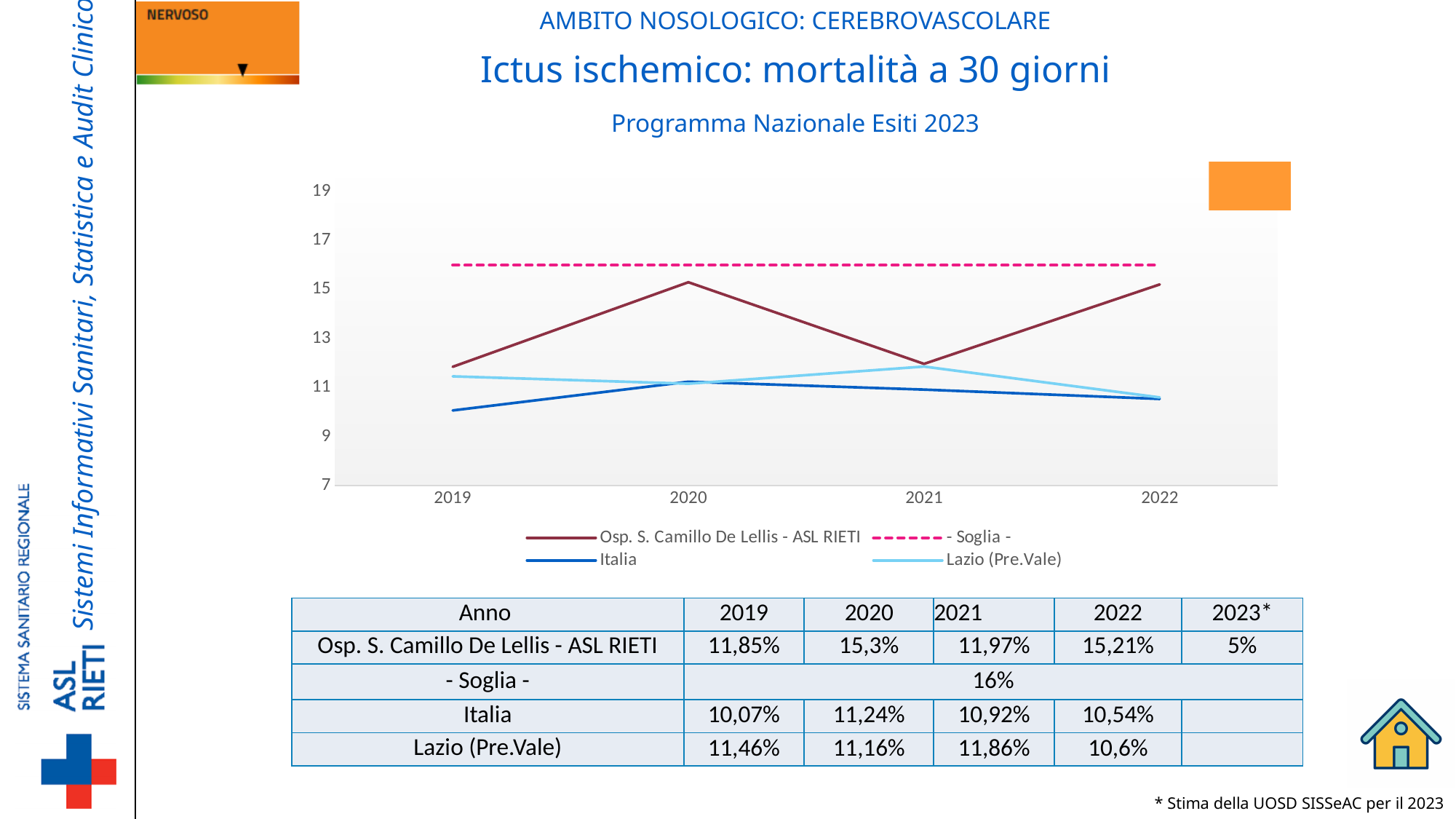
How many series does the chart legend list? 4 Does the Italia line rise or fall from 2020 to 2022? fall What is the difference between the Osp. S. Camillo De Lellis - ASL RIETI value in 2020 and in 2019? 3,45 percentage points How many years are plotted on the x axis of the chart? 4 Is the value for Italia in 2019 greater or less than 11? less In which year is the value for Osp. S. Camillo De Lellis - ASL RIETI highest? 2020 What is the value of the Soglia (threshold) line? 16% In 2020, which is larger: the value for Osp. S. Camillo De Lellis - ASL RIETI or the value for Italia? Osp. S. Camillo De Lellis - ASL RIETI What is the value for Osp. S. Camillo De Lellis - ASL RIETI in 2020? 15,3% What is the value for Italia in 2022? 10,54% In which year is the value for Osp. S. Camillo De Lellis - ASL RIETI lowest? 2019 What kind of chart is shown on the slide? line chart